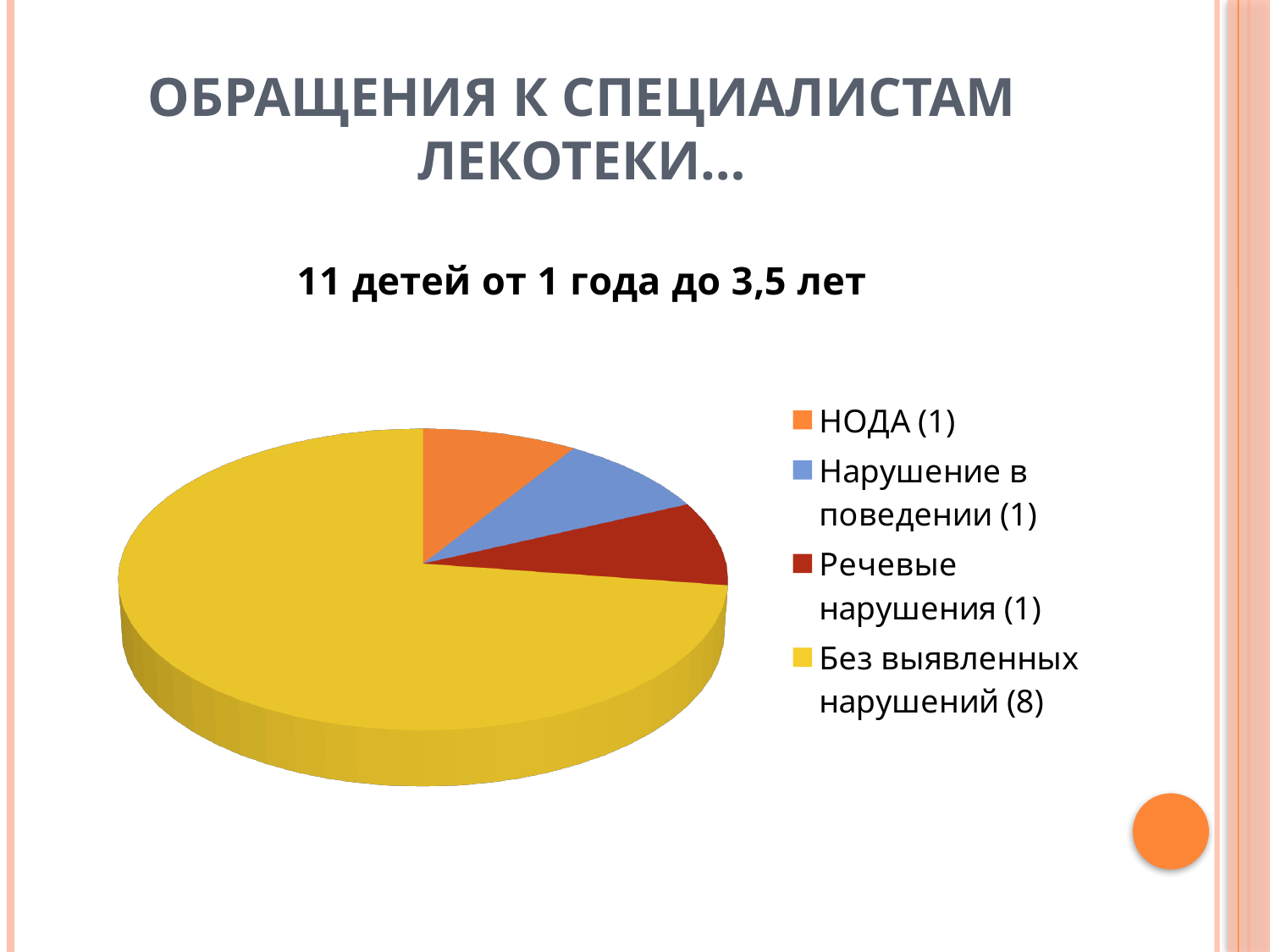
What is the subtitle above the pie chart? 11 детей от 1 года до 3,5 лет How many children are in the category "Без выявленных нарушений"? 8 How many children are in the category "Речевые нарушения"? 1 What is the difference between the number of children in "Без выявленных нарушений" and in "Нарушение в поведении"? 7 How many categories does the pie chart have? 4 How many children are in the category "НОДА"? 1 What colour is the slice for "Без выявленных нарушений"? yellow What kind of chart is shown on the slide? pie chart Which category has the largest slice of the pie chart? Без выявленных нарушений Which is larger: the value for "Без выявленных нарушений" or the value for "Речевые нарушения"? Без выявленных нарушений What colour is the slice for "НОДА"? orange What is the total number of children represented in the pie chart? 11